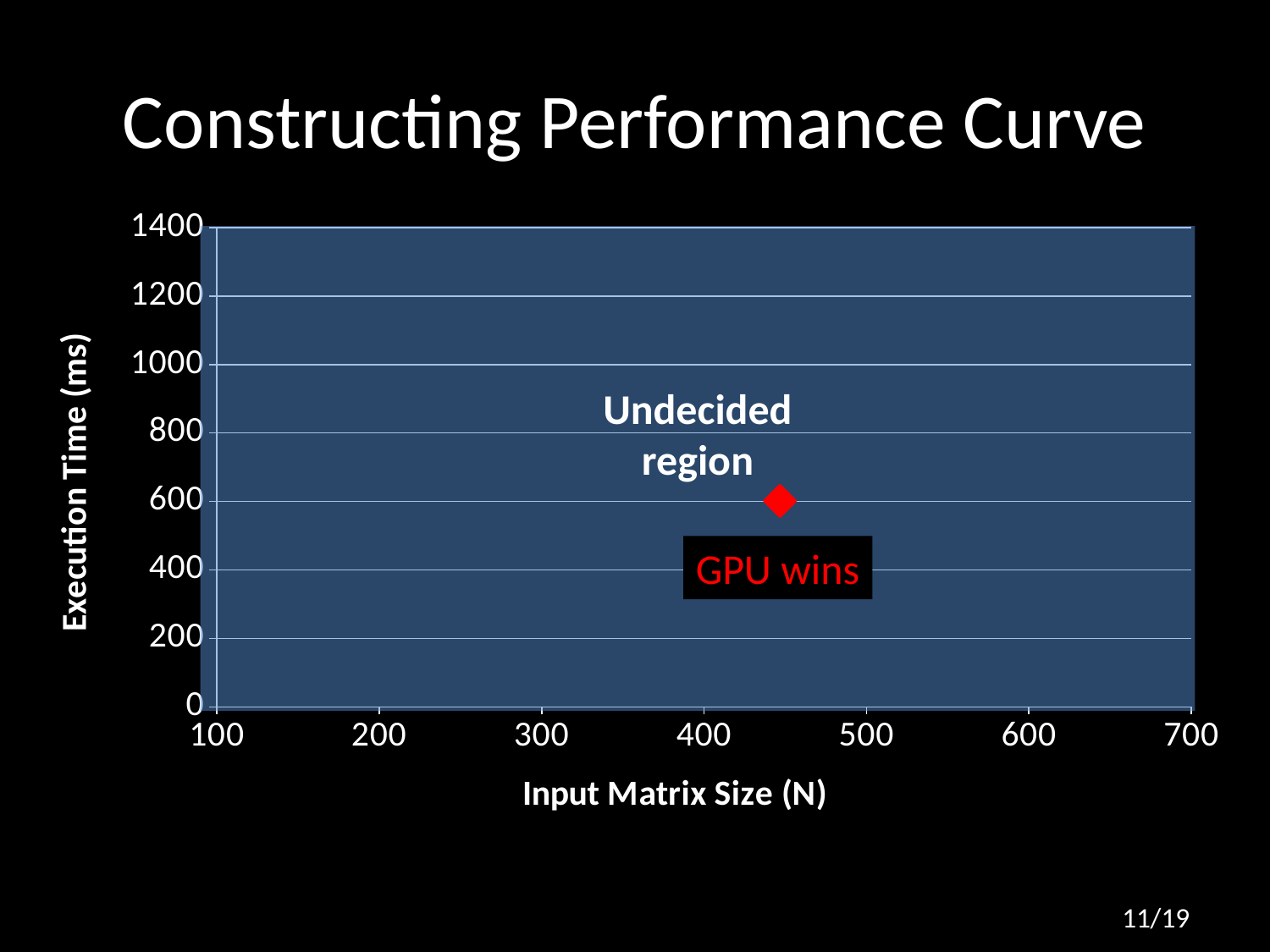
Is the input matrix size of the plotted point greater or less than 400? greater What is the highest value shown on the y axis? 1400 Is the execution time of the plotted point greater or less than 800 ms? less What kind of chart is shown on the slide? scatter chart What text is shown in the black box below the plotted point? GPU wins Is the execution time of the plotted point greater or less than 400 ms? greater What is the execution time (ms) of the plotted point? 600 How many data points are plotted on the chart? 1